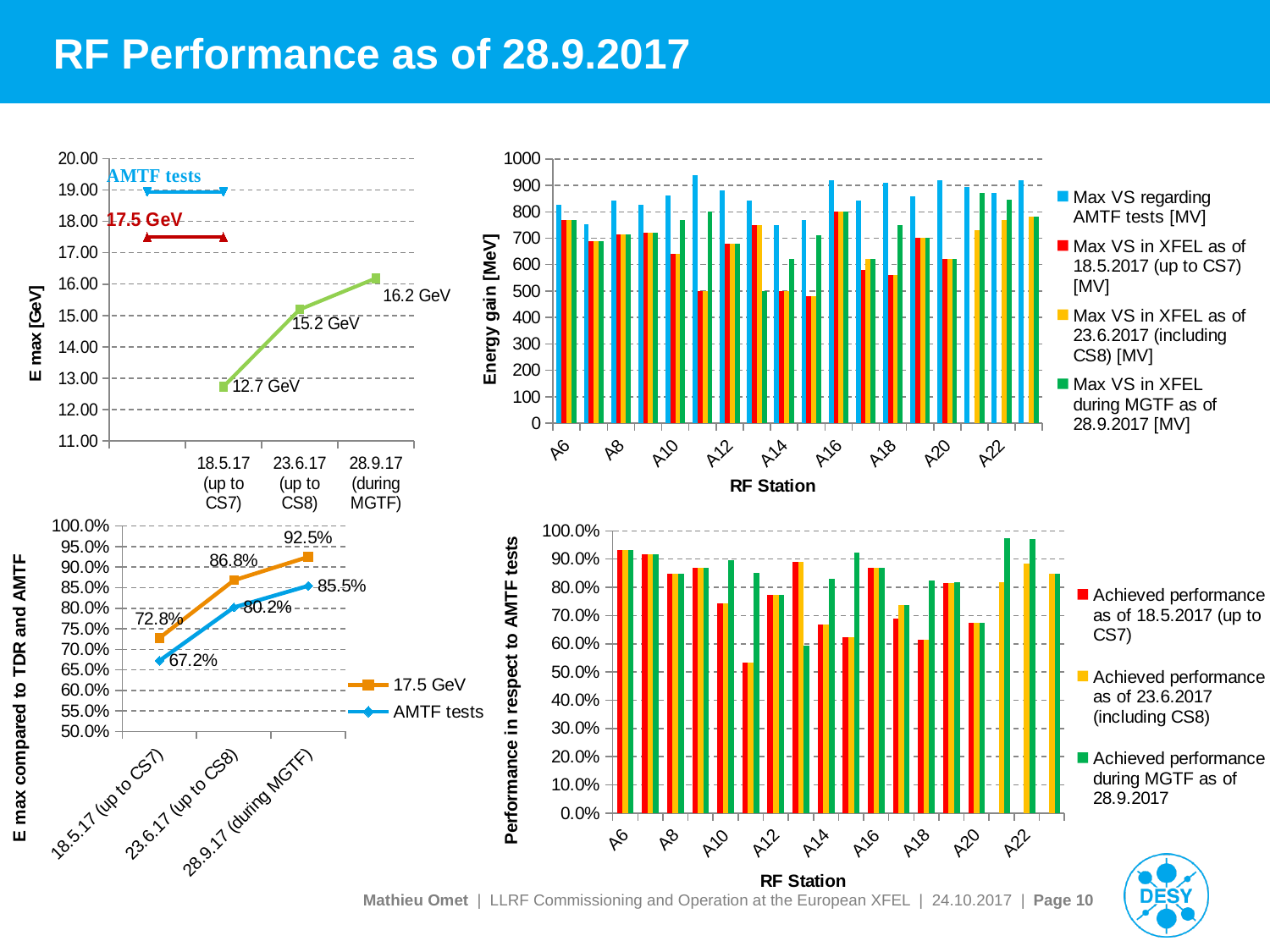
In the top-left E max chart, what is the difference between the E max values for 23.6.17 and 18.5.17? 2.5 GeV In the bottom-right chart (Performance in respect to AMTF tests), is the value of Achieved performance as of 18.5.2017 for A10 greater or less than 80.0%? less In the bottom-left chart (E max compared to TDR and AMTF), which series has the larger value at 28.9.17 (during MGTF)? 17.5 GeV What kind of chart is the top-right Energy gain chart? bar chart In the top-left E max chart, do the E max values rise or fall from 18.5.17 to 28.9.17? rise In the bottom-left chart (E max compared to TDR and AMTF), how many series does the legend list? 2 In the top-left E max chart, what is the E max value for 28.9.17 (during MGTF)? 16.2 GeV In the top-right Energy gain chart, is the value of Max VS in XFEL as of 18.5.2017 for A18 greater or less than 600? less In the bottom-left chart (E max compared to TDR and AMTF), what is the value of the AMTF tests series at 18.5.17 (up to CS7)? 67.2% In the bottom-left chart (E max compared to TDR and AMTF), what is the value of the 17.5 GeV series at 23.6.17 (up to CS8)? 86.8% In the top-right Energy gain chart, how many series does the legend list? 4 In the top-left E max chart, what is the E max value for 18.5.17 (up to CS7)? 12.7 GeV